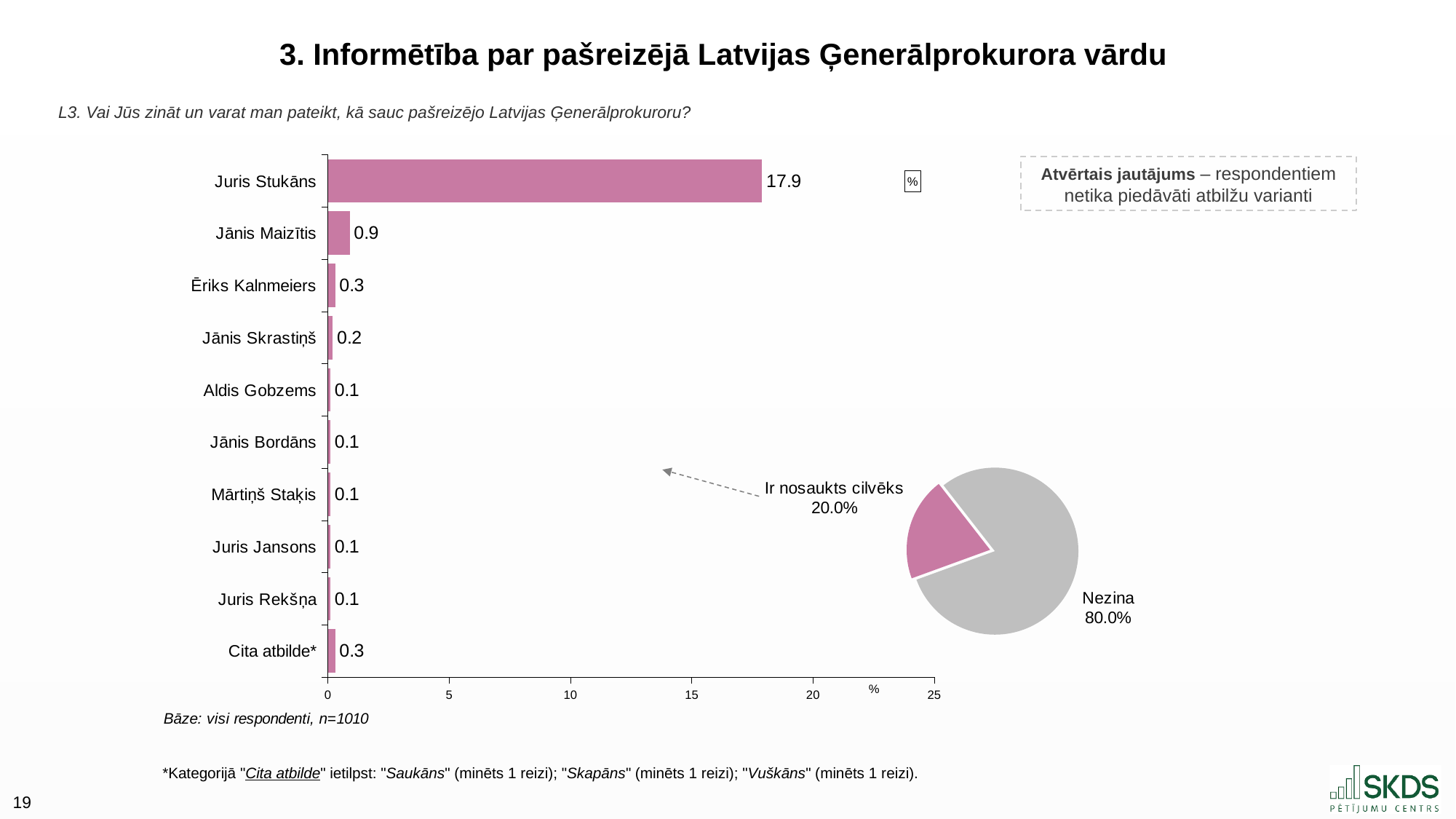
In the pie chart on the right, what is the value for 'Ir nosaukts cilvēks'? 20.0% In the bar chart on the left, what is the value for Juris Stukāns? 17.9 In the bar chart on the left, what is the difference between the values for Juris Stukāns and Jānis Maizītis? 17.0 In the bar chart on the left, what is the value for Jānis Skrastiņš? 0.2 What kind of chart is the chart on the left of the slide? bar chart In the bar chart on the left, what is the value for Jānis Maizītis? 0.9 How many categories are shown in the bar chart on the left? 10 In the bar chart on the left, is the value for Juris Stukāns greater or less than 15? greater What kind of chart is the chart on the right of the slide? pie chart In the pie chart on the right, what share does the 'Nezina' slice have? 80.0% In the bar chart on the left, which category has the highest value? Juris Stukāns In the bar chart on the left, which is larger: the value for Ēriks Kalnmeiers or the value for Jānis Skrastiņš? Ēriks Kalnmeiers